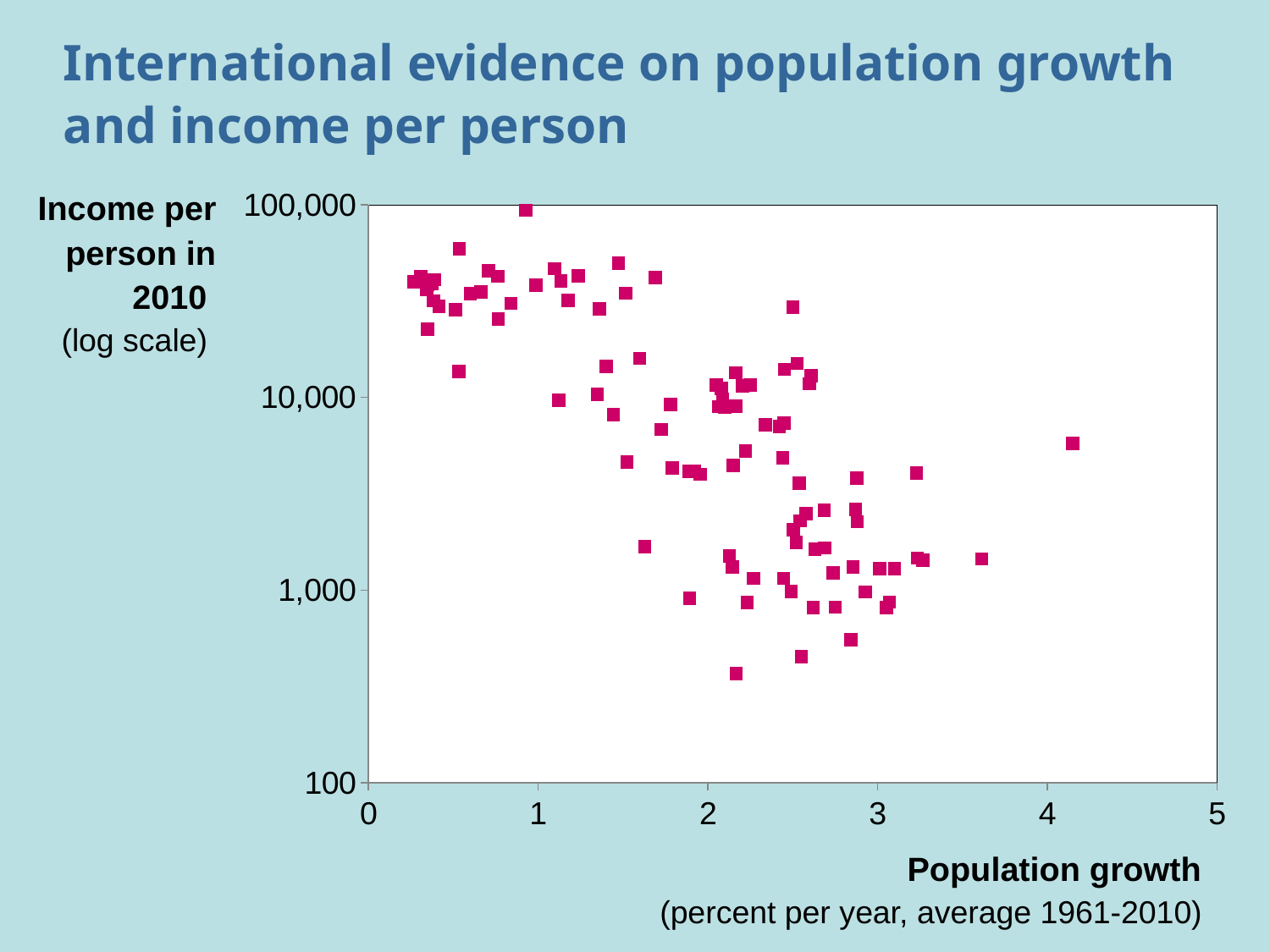
Is the income per person of the lowest point on the chart greater or less than 1,000? less What is the title of the slide's chart? International evidence on population growth and income per person Is the population growth of the point with the highest income per person greater or less than 2? less Are the points with population growth below 1 percent mostly above or below 10,000 in income per person? above What kind of chart is shown on the slide? Scatter plot As population growth increases along the x axis, does income per person tend to rise or fall? Fall What is the highest value shown on the vertical axis? 100,000 What variable is plotted on the horizontal axis? Population growth (percent per year, average 1961-2010)